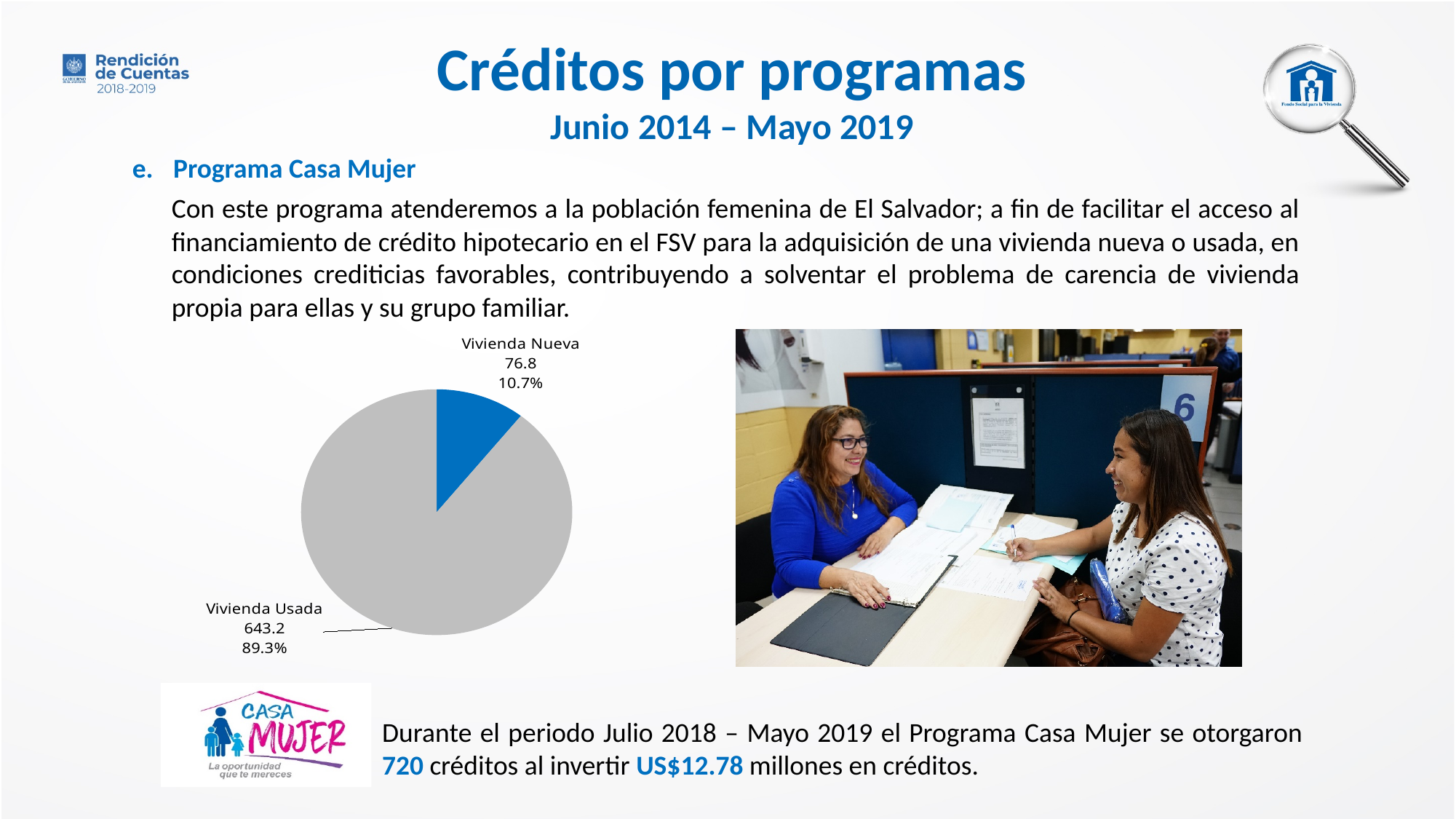
How many categories are shown in the pie chart? 2 What is the value for Vivienda Nueva in the pie chart? 76.8 What colour is the Vivienda Nueva slice in the pie chart? blue What is the difference between the values for Vivienda Usada and Vivienda Nueva? 566.4 Which is larger, the value for Vivienda Nueva or Vivienda Usada? Vivienda Usada What share of the pie does Vivienda Nueva represent? 10.7% Which category has the smallest slice in the pie chart? Vivienda Nueva What is the total of the two values shown in the pie chart? 720 What kind of chart is shown on the slide? pie chart Which category has the largest slice in the pie chart? Vivienda Usada What share of the pie does Vivienda Usada represent? 89.3% What is the value for Vivienda Usada in the pie chart? 643.2